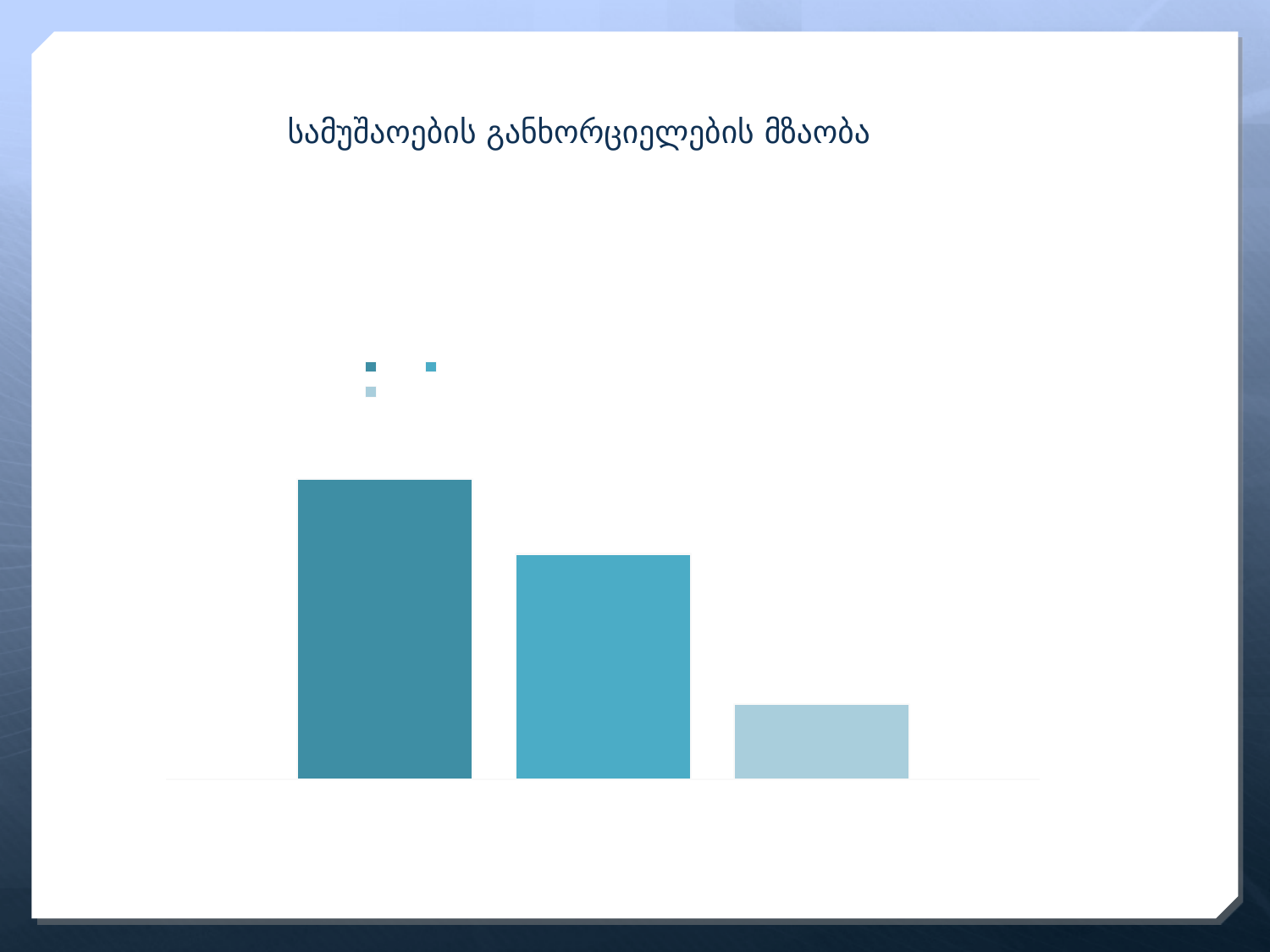
Which bar is the shortest: the leftmost, the middle, or the rightmost? the rightmost Which bar is the tallest: the leftmost, the middle, or the rightmost? the leftmost Do the bar heights rise or fall from left to right across the chart? fall How many bars are plotted in the chart? 3 What is the title shown above the chart? სამუშაოების განხორციელების მზაობა How many entries does the chart's legend list? 3 Which bar has the lightest colour: the leftmost, the middle, or the rightmost? the rightmost Which is taller, the leftmost bar or the middle bar? the leftmost bar What kind of chart is shown on the slide? bar chart Which is taller, the middle bar or the rightmost bar? the middle bar